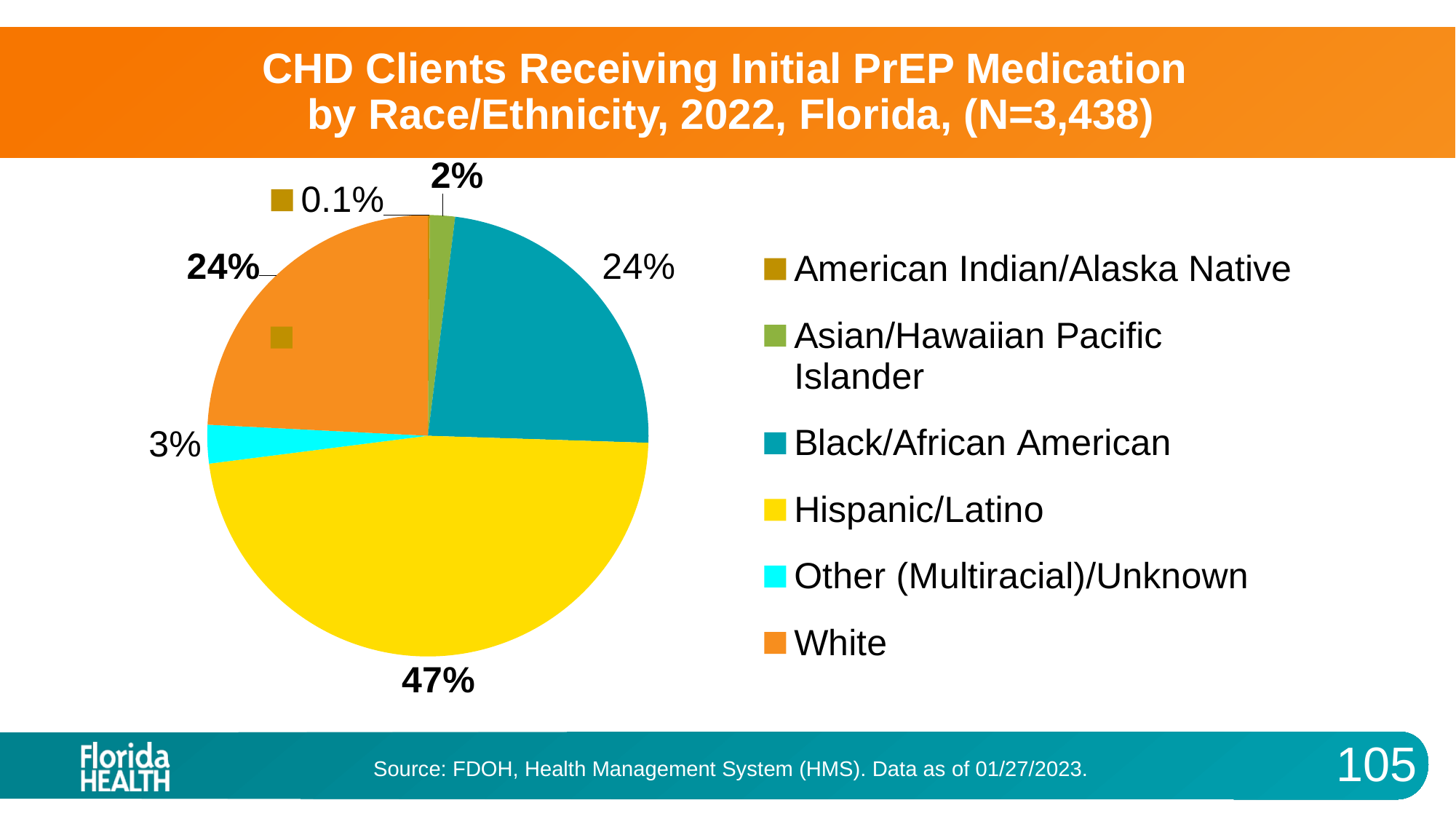
What percentage of clients were Black/African American? 24% How many percentage points larger is the Hispanic/Latino share than the Black/African American share? 23 What share of CHD clients receiving initial PrEP medication were Hispanic/Latino? 47% How many race/ethnicity categories does the legend list? 6 Which race/ethnicity group has the smallest share of the pie? American Indian/Alaska Native What share of clients were Asian/Hawaiian Pacific Islander? 2% What share of clients fell into the Other (Multiracial)/Unknown category? 3% What percentage of clients were American Indian/Alaska Native? 0.1% Which race/ethnicity group has the largest share of the pie? Hispanic/Latino Which is larger, the share for Other (Multiracial)/Unknown or the share for Asian/Hawaiian Pacific Islander? Other (Multiracial)/Unknown What percentage of clients were White? 24% What type of chart is shown on the slide? Pie chart